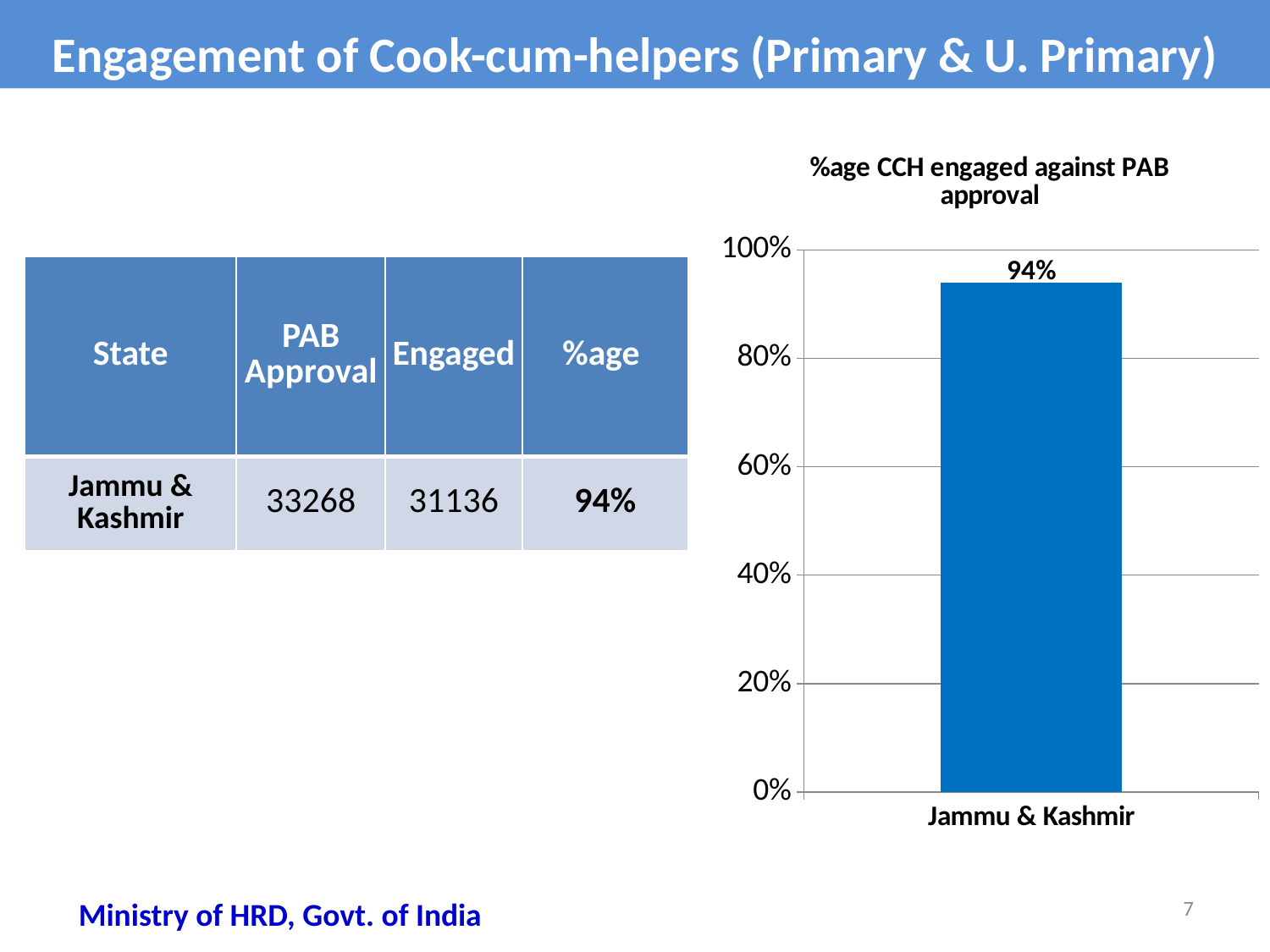
What kind of chart is shown on the slide? bar chart Is the value for Jammu & Kashmir greater or less than 80%? greater What is the title of the chart? %age CCH engaged against PAB approval What is the value shown for Jammu & Kashmir in the chart? 94% Is the value for Jammu & Kashmir greater or less than 100%? less How many categories are plotted in the chart? 1 Which category is labelled on the x axis of the chart? Jammu & Kashmir What is the highest value shown on the chart's vertical axis? 100%